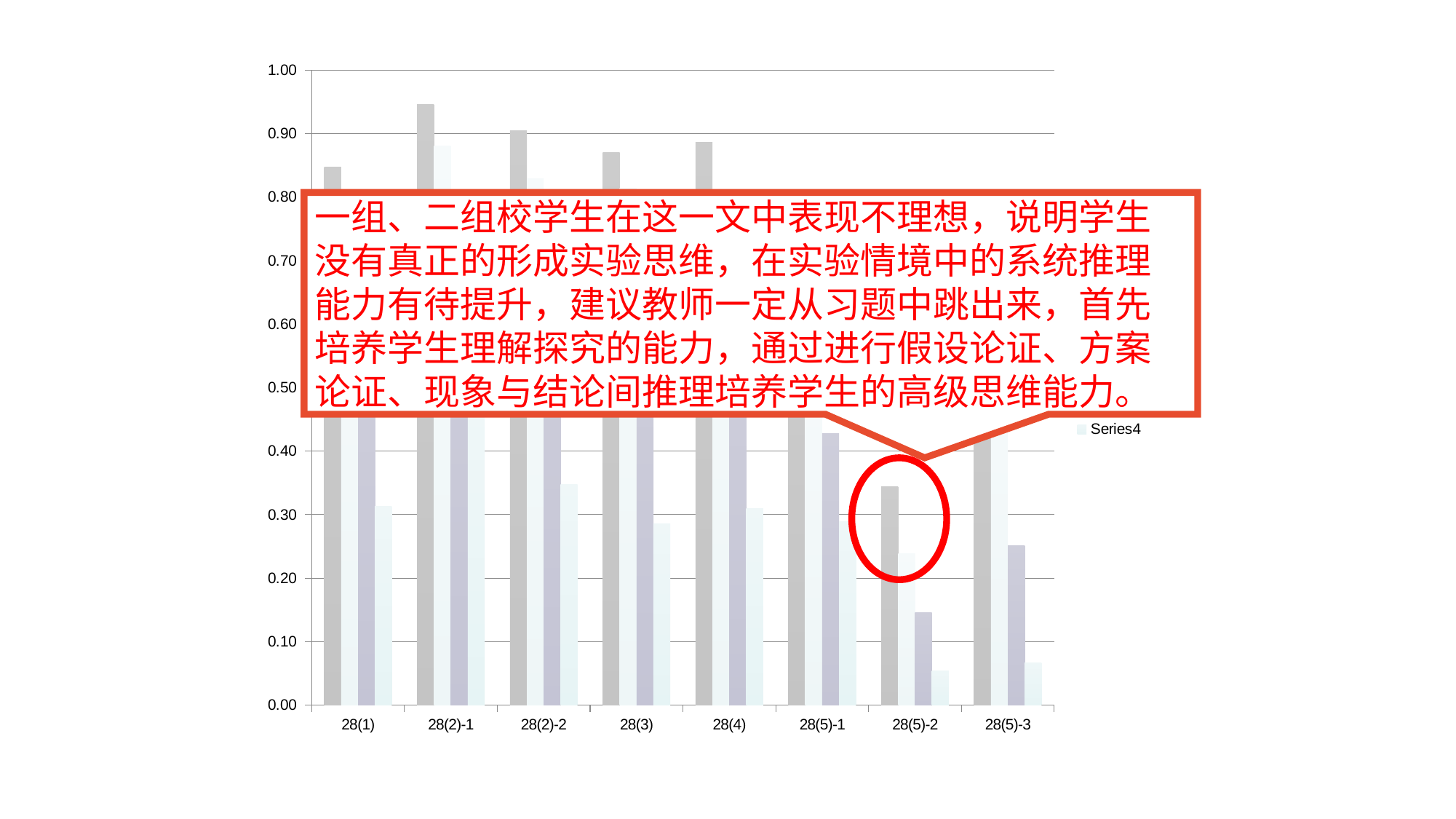
How many categories are shown on the x axis of the chart? 8 What kind of chart is shown on the slide? bar chart Is the value of the first (gray) bar for 28(5)-2 greater or less than 0.40? less Is the Series4 value for 28(3) greater or less than 0.30? less Which legend entry is visible on the chart? Series4 What is the highest value shown on the y axis of the chart? 1.00 Is the value of the first (gray) bar for 28(2)-1 greater or less than 0.90? greater Which is larger: the first (gray) bar for 28(1) or the first (gray) bar for 28(5)-2? 28(1) Among the first (gray) bars, which category has the lowest value? 28(5)-2 Among the first (gray) bars, which category has the highest value? 28(2)-1